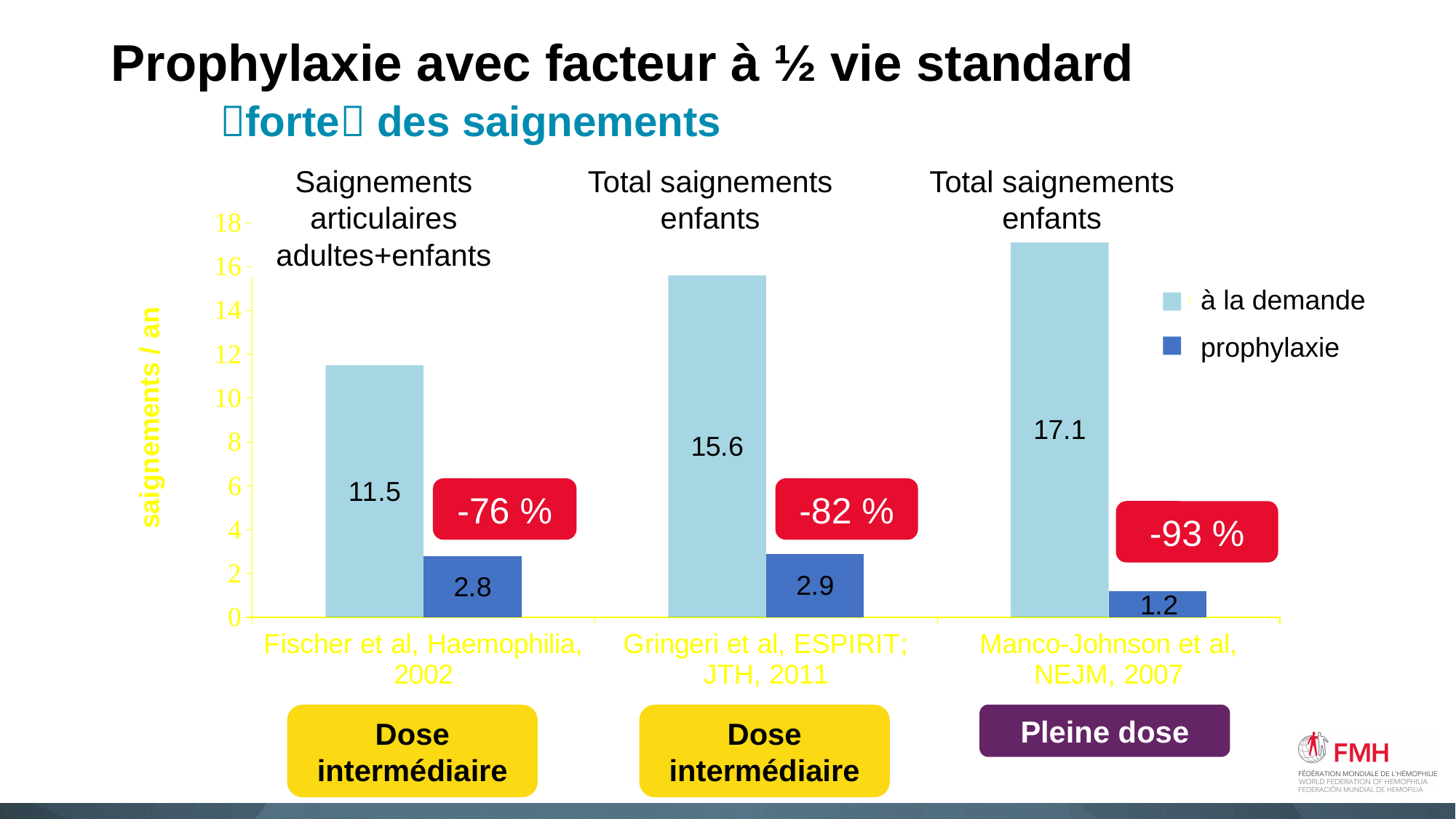
What kind of chart is shown on the slide? bar chart What is the 'prophylaxie' value for Manco-Johnson et al, NEJM, 2007? 1.2 How many series does the legend list? 2 Which study has the lowest 'prophylaxie' value? Manco-Johnson et al, NEJM, 2007 Is the 'à la demande' value for Manco-Johnson et al, NEJM, 2007 greater or less than 16? greater What is the difference between the 'à la demande' and 'prophylaxie' values for Gringeri et al, ESPIRIT; JTH, 2011? 12.7 What percentage reduction is shown in the red box for Manco-Johnson et al, NEJM, 2007? -93 % What is the 'à la demande' value for Fischer et al, Haemophilia, 2002? 11.5 How many studies (categories) are shown on the x axis? 3 What is the 'prophylaxie' value for Gringeri et al, ESPIRIT; JTH, 2011? 2.9 Which study has the highest 'à la demande' value? Manco-Johnson et al, NEJM, 2007 Which is larger: the 'à la demande' value for Fischer et al, Haemophilia, 2002 or for Gringeri et al, ESPIRIT; JTH, 2011? Gringeri et al, ESPIRIT; JTH, 2011